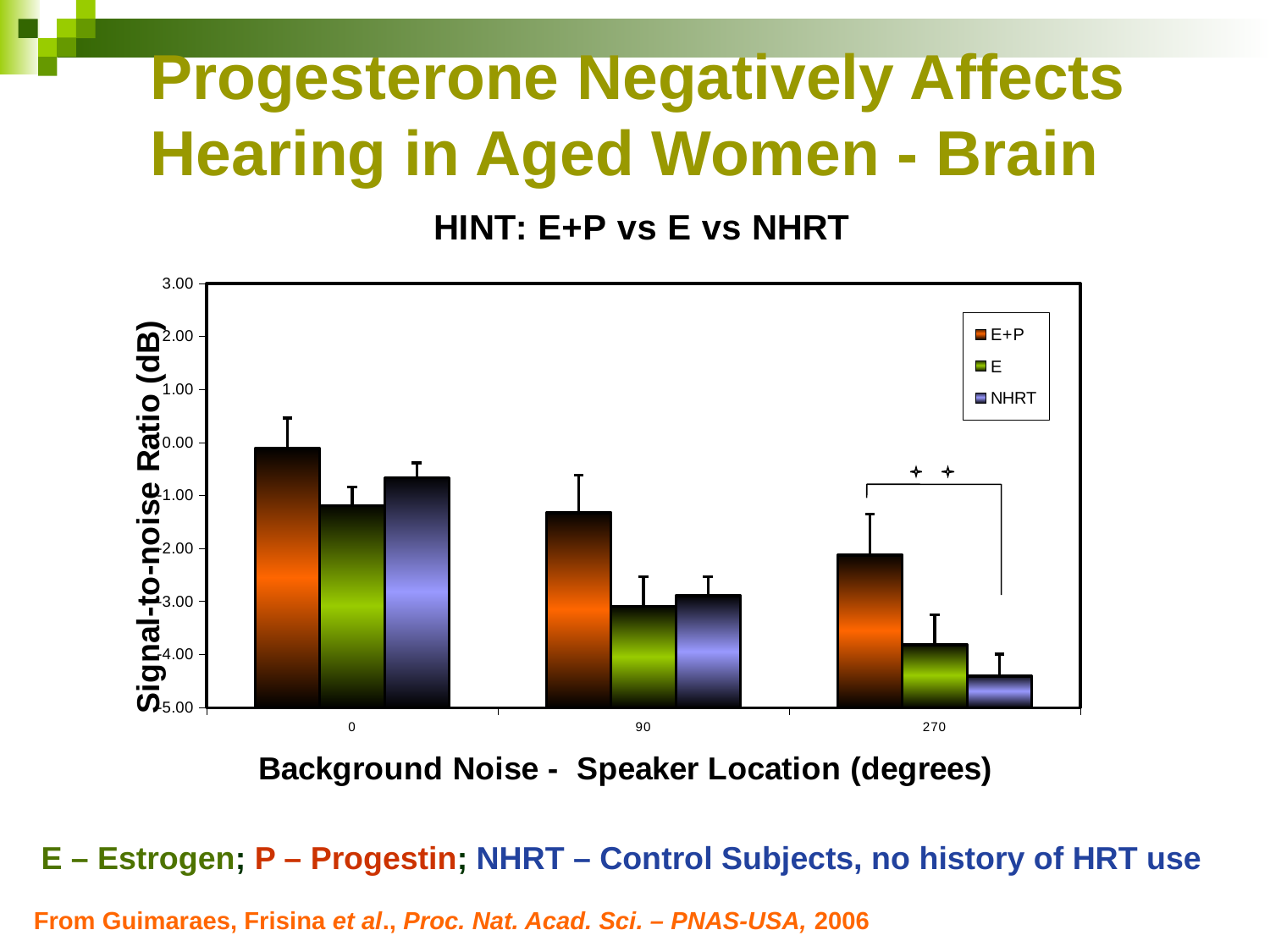
At which speaker location is the E+P value highest? 0 Is the value for NHRT at 0 degrees greater or less than -1.00? greater How many speaker location categories are shown on the x axis? 3 Is the value for E at 270 degrees greater or less than -3.00? less Which series has the highest signal-to-noise ratio at 270 degrees? E+P Is the value for E+P at 90 degrees greater or less than -1.00? less How many series does the legend list? 3 Which series has the lowest signal-to-noise ratio at 270 degrees? NHRT At 0 degrees, which is larger, the value for E or the value for NHRT? NHRT What is the label of the y axis? Signal-to-noise Ratio (dB) Do the E+P values rise or fall as the speaker location goes from 0 to 270 degrees? fall What kind of chart is shown on the slide? bar chart